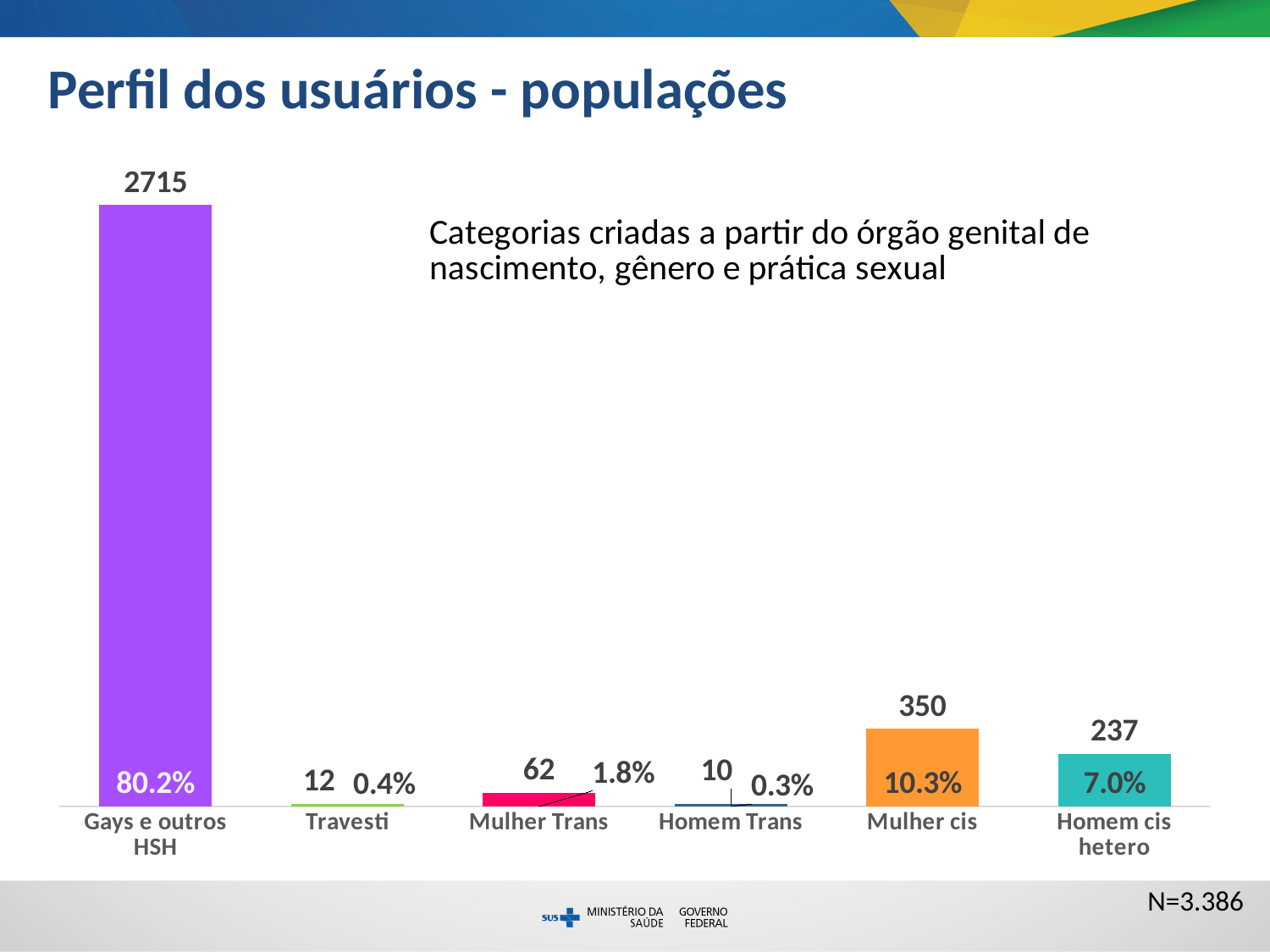
What is the count shown for Homem cis hetero? 237 Which has a larger count, Travesti or Mulher Trans? Mulher Trans What kind of chart is shown on the slide? Bar chart What is the difference between the counts for Mulher Trans and Homem Trans? 52 What is the difference between the counts for Mulher cis and Homem cis hetero? 113 How many categories are shown in the chart? 6 What is the total N stated on the slide? N=3.386 Which category has the lowest count? Homem Trans What percentage is shown for Mulher Trans? 1.8% Which category has the highest count? Gays e outros HSH What percentage is shown for Mulher cis? 10.3% What is the count shown for Gays e outros HSH? 2715